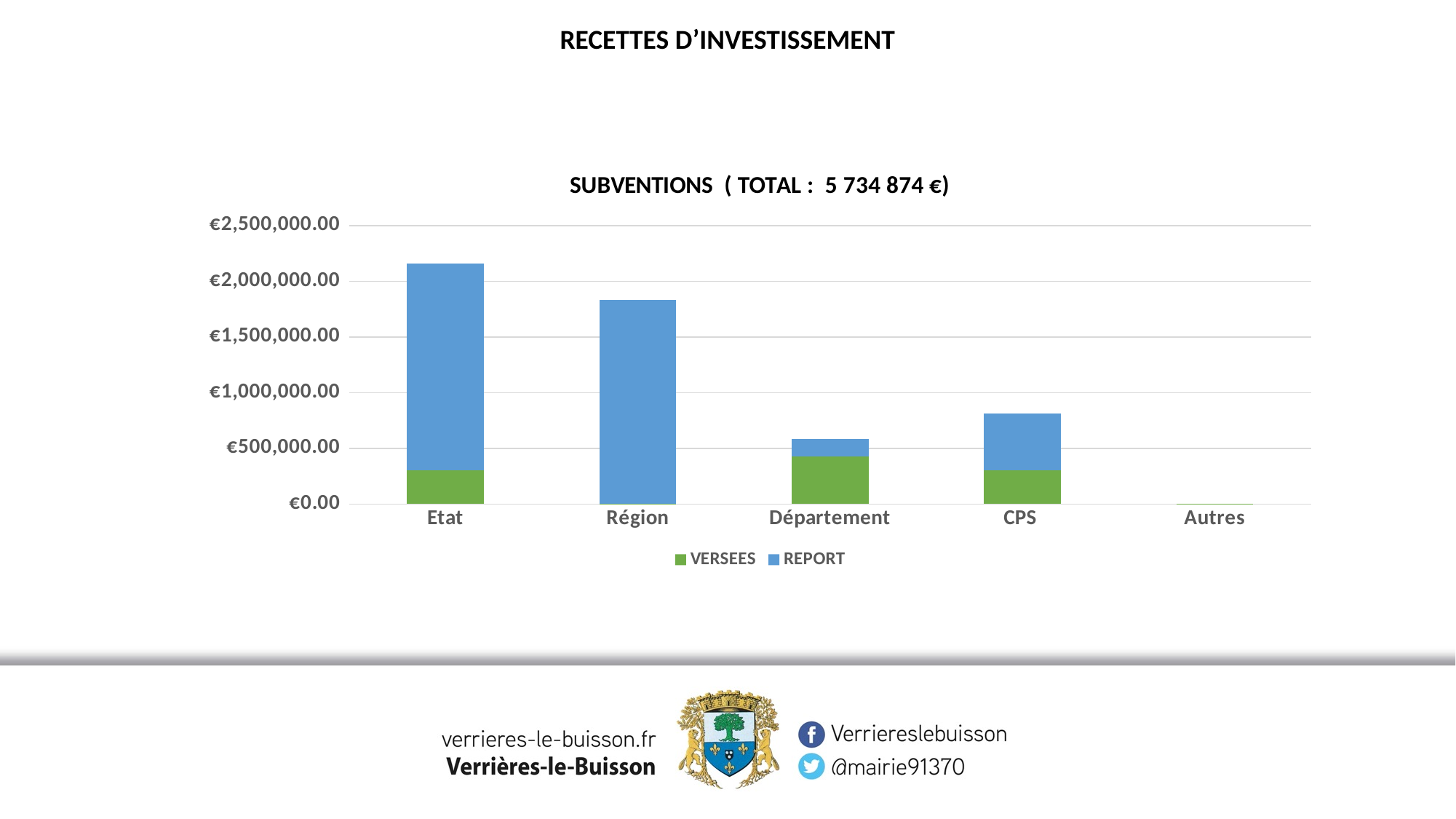
Which series is shown in green in the chart? VERSEES What kind of chart is shown on the slide? Stacked bar chart Is the total stacked value for Région greater or less than €2,000,000.00? less What total amount is stated in the chart title? 5 734 874 € Which stacked bar is taller, CPS or Département? CPS How many series does the legend list? 2 Which category has the smallest stacked bar? Autres Is the total stacked value for CPS greater or less than €1,000,000.00? less Which stacked bar is taller, Etat or Région? Etat Which category has the tallest stacked bar? Etat Is the total stacked value for Etat greater or less than €2,000,000.00? greater How many categories are shown on the x axis of the chart? 5